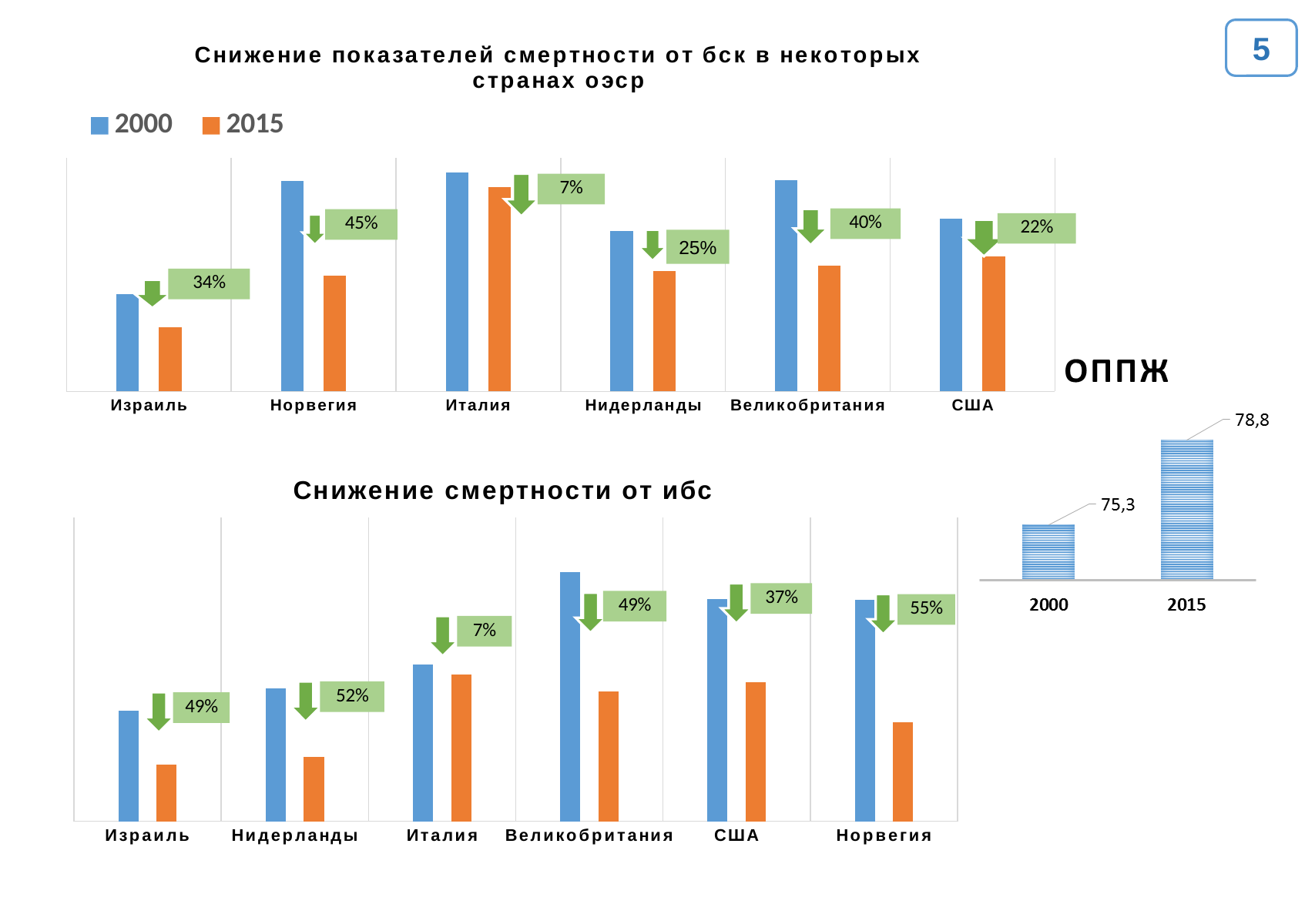
In the top chart (Снижение показателей смертности от бск), which country has the highest 2000 value? Италия In the bottom chart (Снижение смертности от ибс), what percentage decrease is shown for Нидерланды? 52% In the ОППЖ chart on the right, what is the difference between the 2015 and 2000 values? 3,5 In the top chart (Снижение показателей смертности от бск), what percentage decrease is shown for США? 22% In the bottom chart (Снижение смертности от ибс), what percentage decrease is shown for Норвегия? 55% In the bottom chart (Снижение смертности от ибс), which country has the highest 2000 value? Великобритания In the top chart (Снижение показателей смертности от бск), what percentage decrease is shown for Италия? 7% How many countries are shown in the bottom chart (Снижение смертности от ибс)? 6 In the top chart (Снижение показателей смертности от бск), which country has the lowest 2000 value? Израиль In the ОППЖ chart on the right, what is the value for 2015? 78,8 How many series does the legend of the top chart list? 2 In the top chart (Снижение показателей смертности от бск), what percentage decrease is shown for Норвегия? 45%